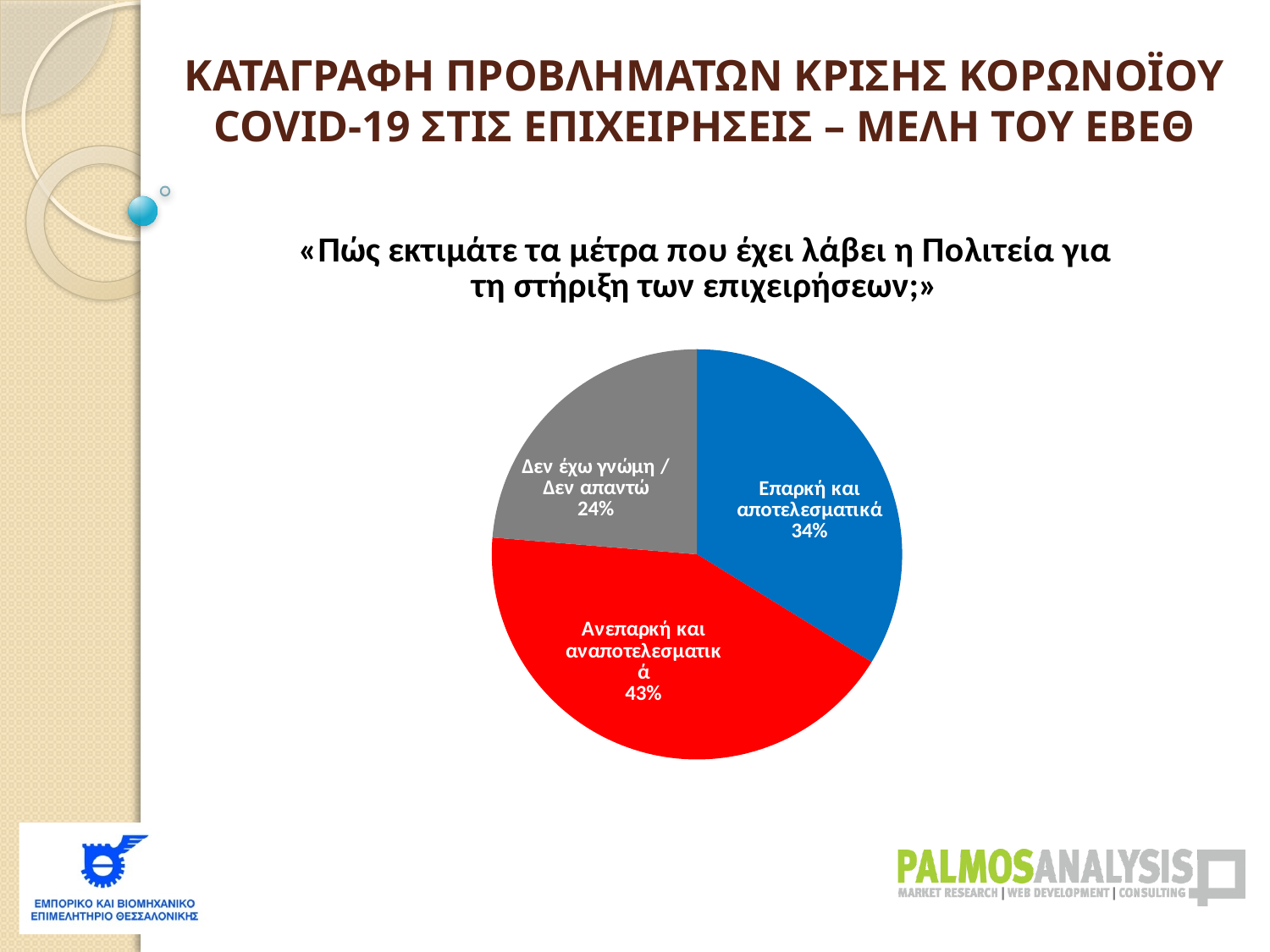
What kind of chart is shown on the slide? pie chart Which is larger: the share for "Επαρκή και αποτελεσματικά" or the share for "Δεν έχω γνώμη / Δεν απαντώ"? Επαρκή και αποτελεσματικά What is the difference in percentage points between "Ανεπαρκή και αναποτελεσματικά" and "Επαρκή και αποτελεσματικά"? 9 percentage points What share of respondents answered "Επαρκή και αποτελεσματικά"? 34% Which response has the smallest share of the pie? Δεν έχω γνώμη / Δεν απαντώ Which response has the largest share of the pie? Ανεπαρκή και αναποτελεσματικά What share of respondents answered "Ανεπαρκή και αναποτελεσματικά"? 43% How many slices does the pie chart have? 3 What share of respondents answered "Δεν έχω γνώμη / Δεν απαντώ"? 24% What is the difference in percentage points between "Επαρκή και αποτελεσματικά" and "Δεν έχω γνώμη / Δεν απαντώ"? 10 percentage points What question does the pie chart present responses to? «Πώς εκτιμάτε τα μέτρα που έχει λάβει η Πολιτεία για τη στήριξη των επιχειρήσεων;» What colour is the slice for "Ανεπαρκή και αναποτελεσματικά"? red